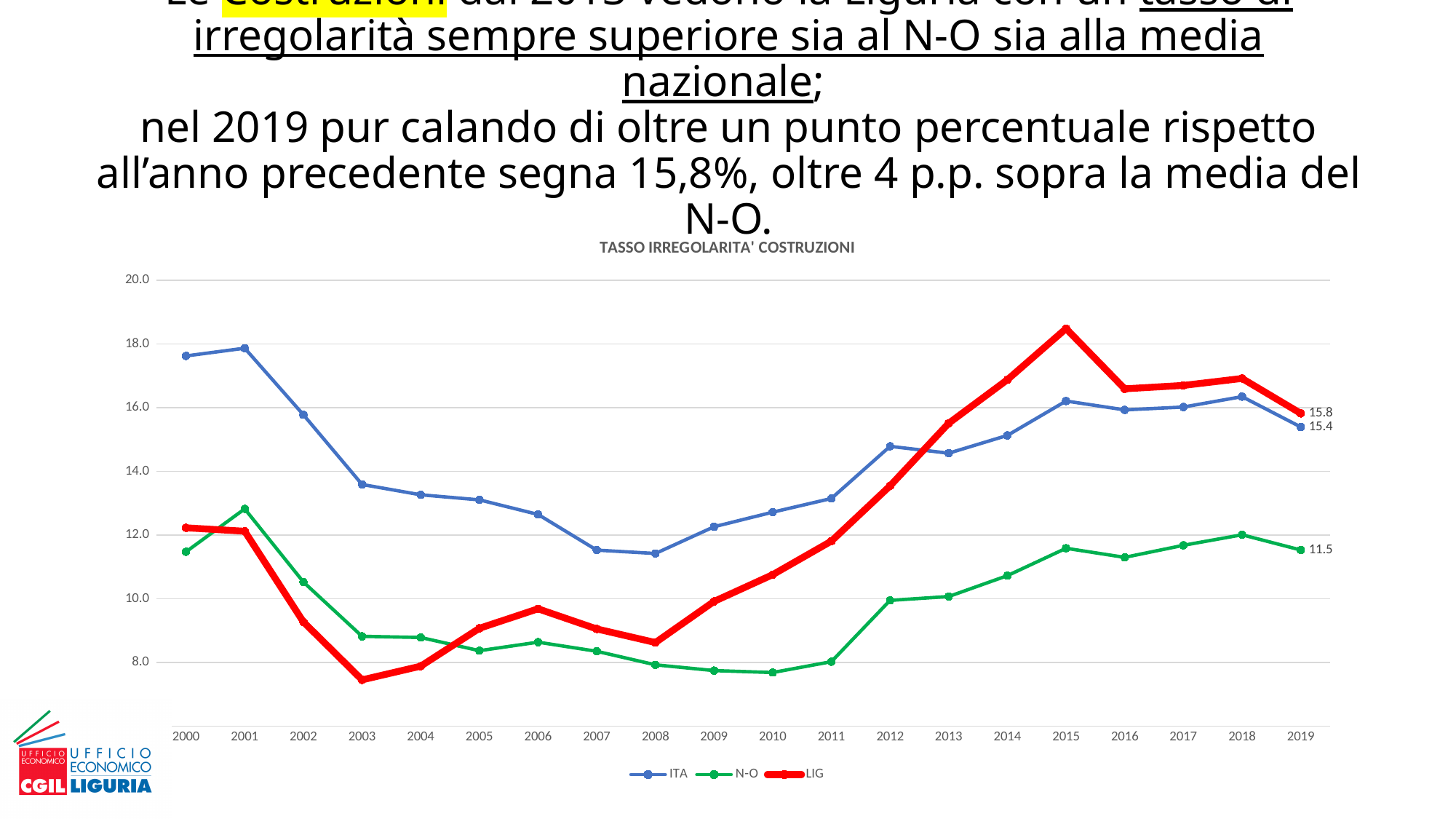
Which series has the highest value in 2019? LIG Is the value for LIG in 2003 greater or less than 8.0? less What kind of chart is shown? line chart In which year does the LIG series reach its highest value? 2015 What is the value for N-O in 2019? 11.5 How many series does the legend list? 3 Is the value for LIG in 2015 greater or less than 18.0? greater Is the value for ITA in 2008 greater or less than 12.0? less What is the value for LIG in 2019? 15.8 What is the value for ITA in 2019? 15.4 What is the difference between the LIG and N-O values in 2019? 4.3 How many years are shown on the x axis? 20